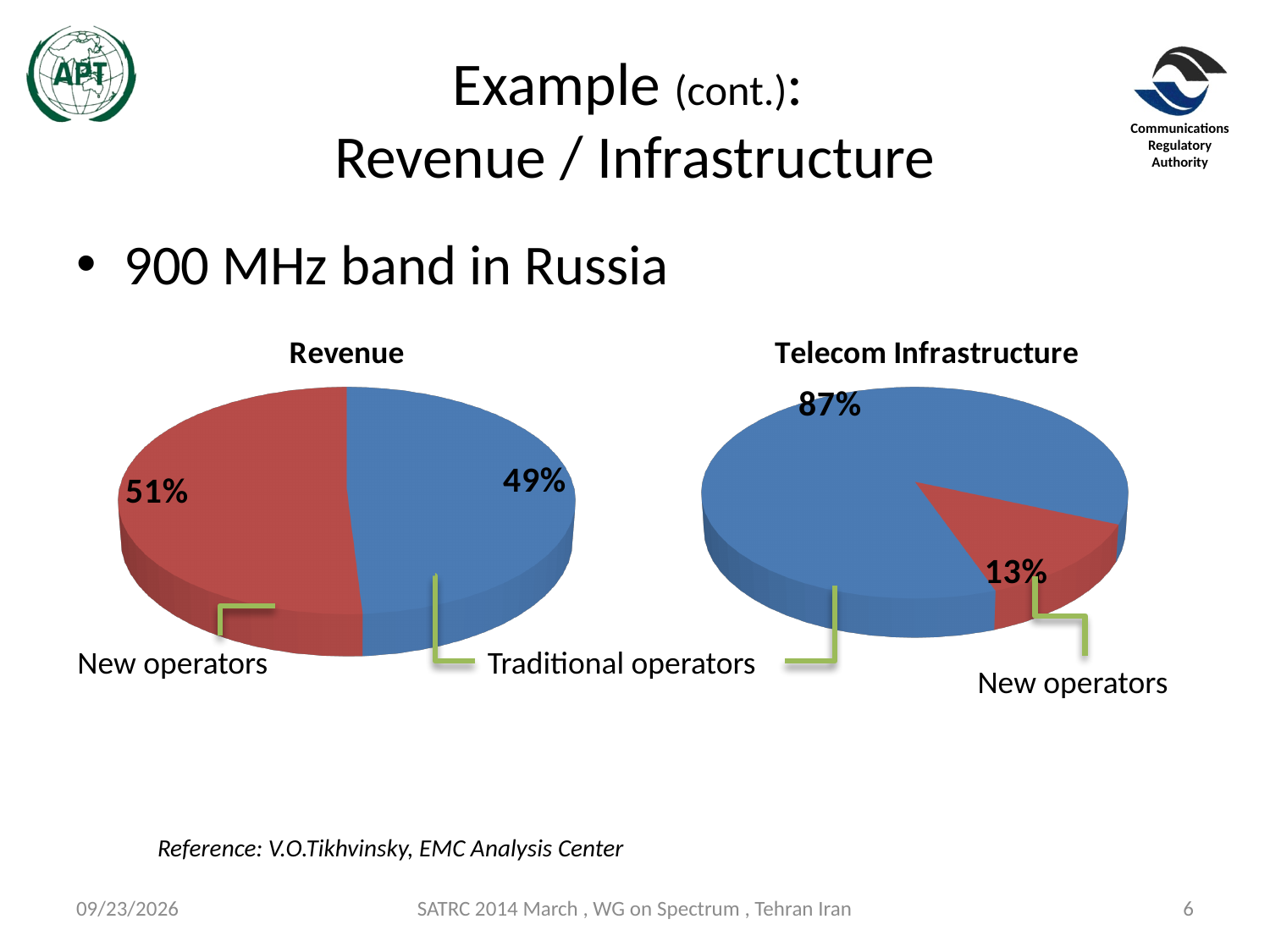
In the Telecom Infrastructure chart, which group has the largest slice? Traditional operators Which is larger: the New operators share in the Revenue chart or the New operators share in the Telecom Infrastructure chart? Revenue In the Telecom Infrastructure chart, what share do New operators have? 13% In the Revenue chart, what share do New operators have? 51% In the Telecom Infrastructure chart, what share do Traditional operators have? 87% In the Telecom Infrastructure chart, which group has the smallest slice? New operators In the Revenue chart, what is the difference between the New operators share and the Traditional operators share? 2% In the Telecom Infrastructure chart, what is the difference between the Traditional operators share and the New operators share? 74% What colour is the New operators slice in the Revenue chart? red How many slices does the Telecom Infrastructure pie chart have? 2 In the Revenue chart, what share do Traditional operators have? 49% What kind of chart is the Revenue chart? pie chart